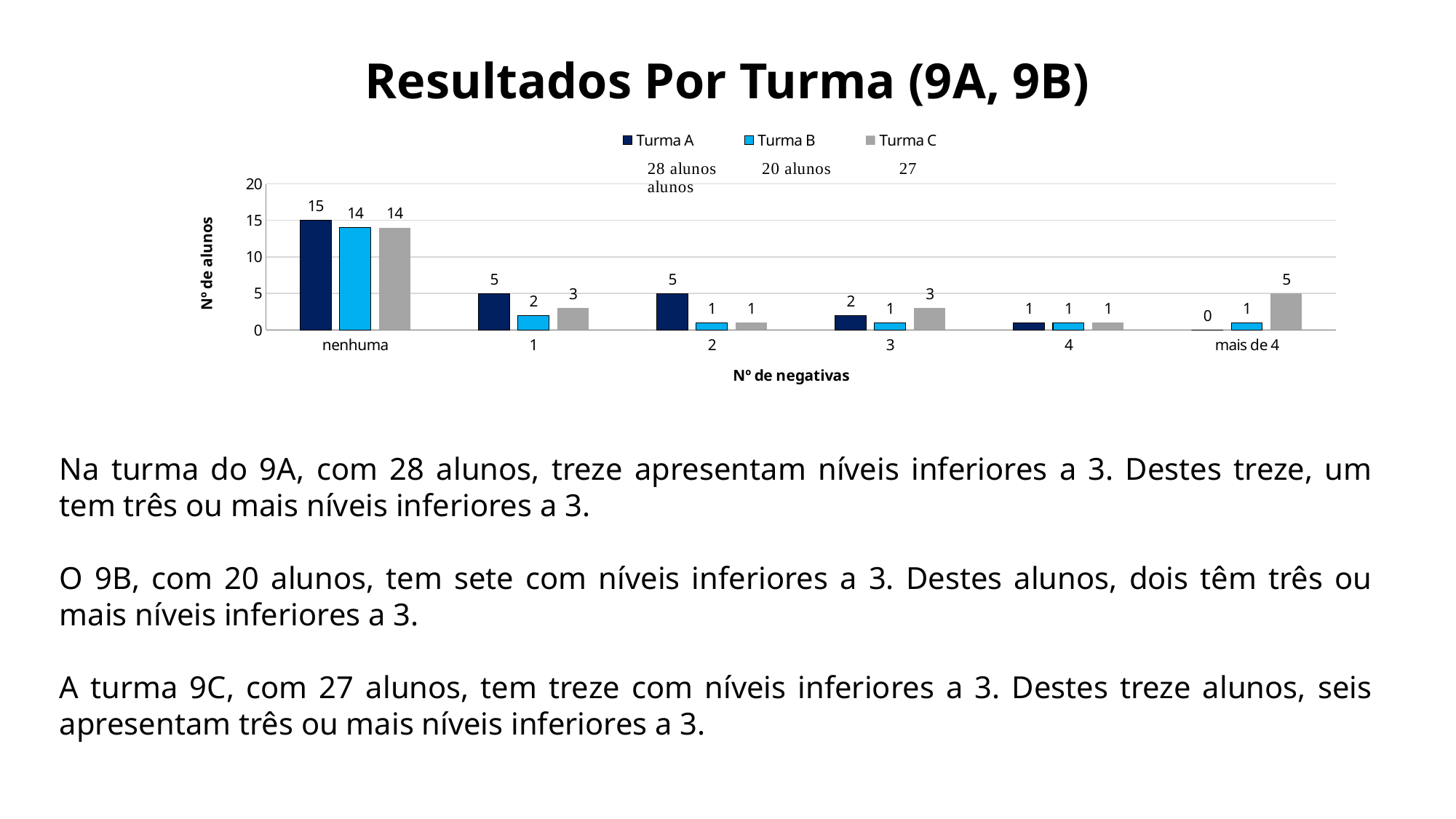
How many categories are shown on the x axis of the chart? 6 What is the label of the y axis of the chart? Nº de alunos Which category has the highest value for Turma C? nenhuma What is the difference between Turma A and Turma B in the '2' category? 4 What is the label of the x axis of the chart? Nº de negativas What is the value for Turma C in the 'mais de 4' category? 5 What is the value for Turma A in the 'nenhuma' category? 15 Which is larger in the '3' category: Turma A or Turma C? Turma C How many series does the chart legend list? 3 What is the value for Turma B in the '1' category? 2 Which category has the lowest value for Turma A? mais de 4 What type of chart is shown on the slide? bar chart